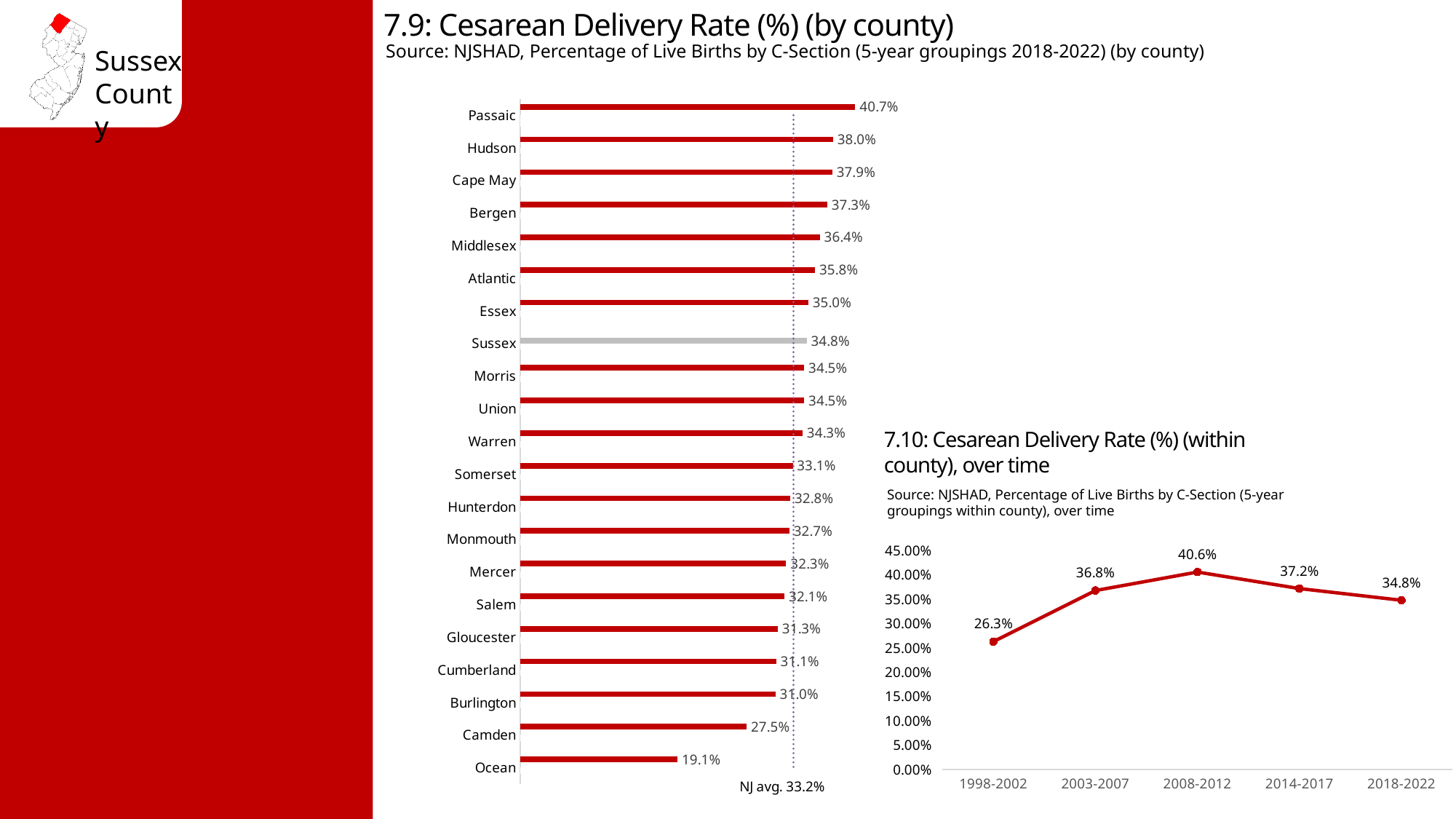
In the 7.9 Cesarean Delivery Rate (by county) chart, which is larger, the value for Hudson or the value for Camden? Hudson In the 7.10 Cesarean Delivery Rate (within county) over time chart, does the value rise or fall from 2008-2012 to 2018-2022? Fall In the 7.9 Cesarean Delivery Rate (by county) chart, what is the NJ average shown? 33.2% What kind of chart is the 7.9 Cesarean Delivery Rate (by county) chart? Bar chart In the 7.10 Cesarean Delivery Rate (within county) over time chart, what is the value for 2008-2012? 40.6% In the 7.9 Cesarean Delivery Rate (by county) chart, which county has the lowest rate? Ocean In the 7.10 Cesarean Delivery Rate (within county) over time chart, which period has the lowest value? 1998-2002 In the 7.10 Cesarean Delivery Rate (within county) over time chart, what is the difference between 2008-2012 and 2018-2022? 5.8% In the 7.9 Cesarean Delivery Rate (by county) chart, which county has the highest rate? Passaic In the 7.9 Cesarean Delivery Rate (by county) chart, what is the value for Sussex? 34.8% In the 7.9 Cesarean Delivery Rate (by county) chart, how many counties are shown? 21 In the 7.9 Cesarean Delivery Rate (by county) chart, what is the difference between Passaic and Ocean? 21.6%